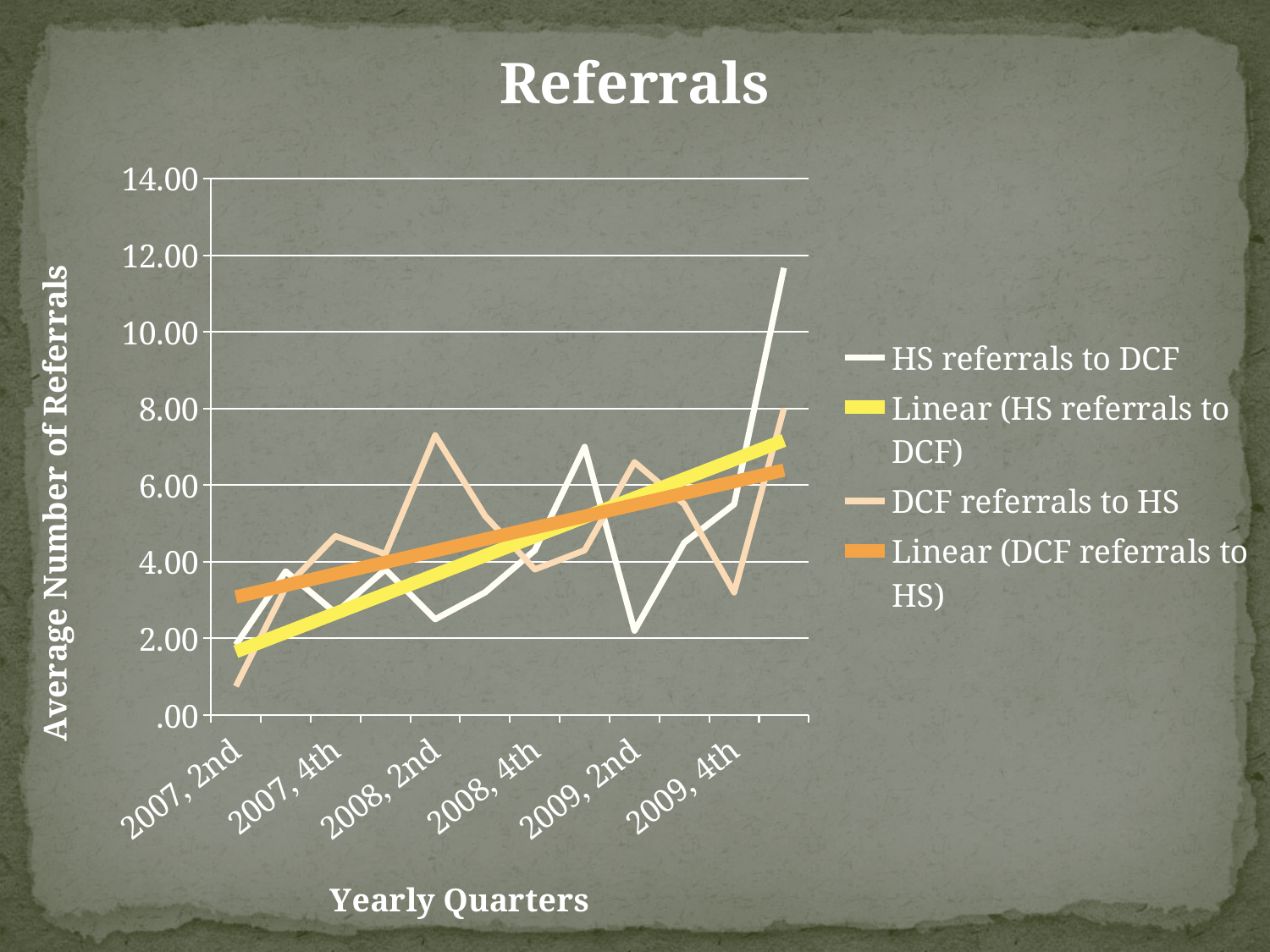
At 2008, 2nd, which series has the larger value: HS referrals to DCF or DCF referrals to HS? DCF referrals to HS At 2009, 4th, which series has the larger value: HS referrals to DCF or DCF referrals to HS? HS referrals to DCF What kind of chart is shown on the slide? line chart Is the value for DCF referrals to HS at 2009, 4th greater or less than 4.00? less Does the Linear (HS referrals to DCF) trendline rise or fall from left to right? rise Is the value for DCF referrals to HS at 2007, 2nd greater or less than 2.00? less What is the label of the vertical axis? Average Number of Referrals Is the value for HS referrals to DCF at 2008, 2nd greater or less than 4.00? less How many series does the legend list? 4 What is the title of the chart? Referrals